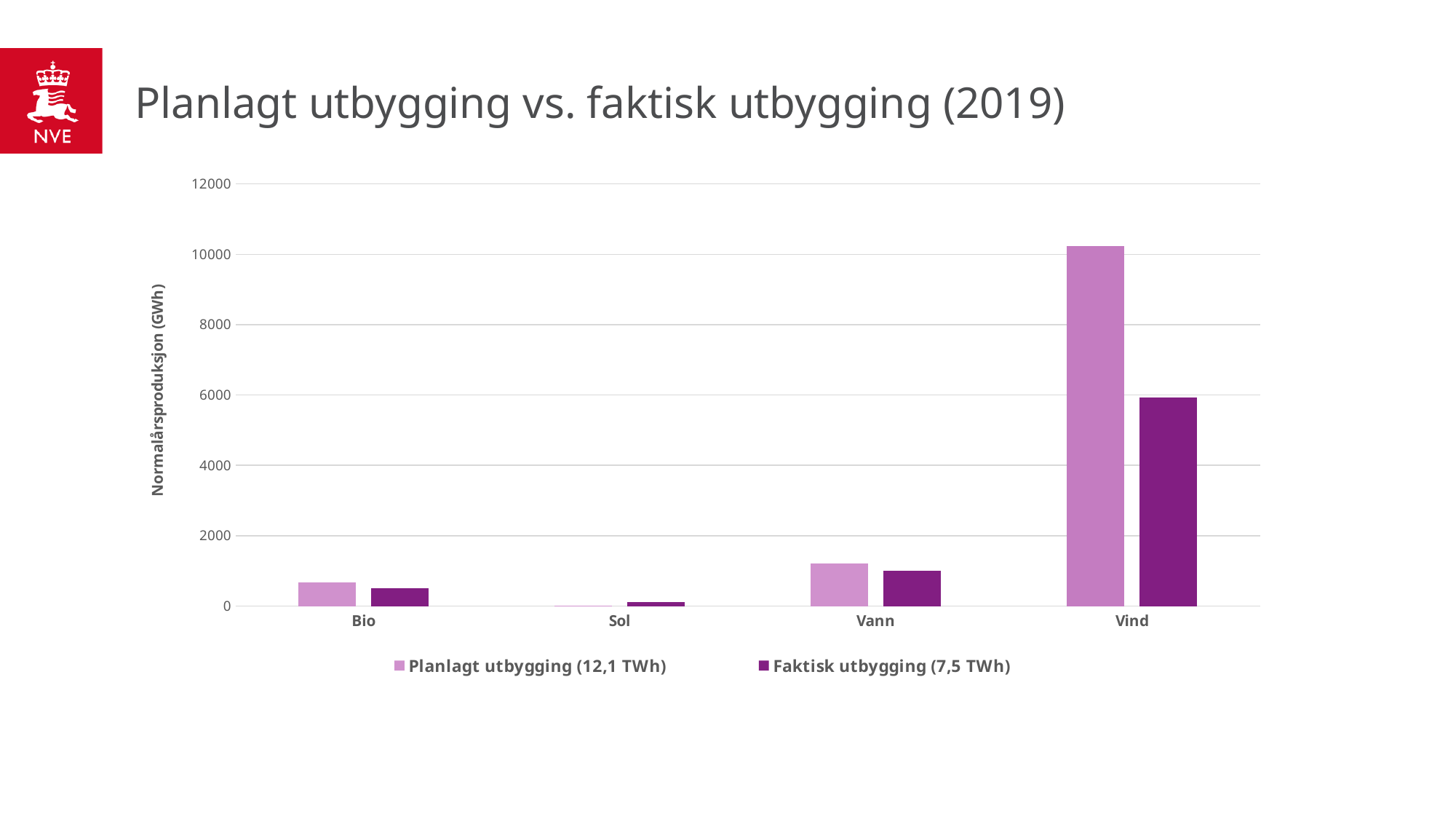
For Vind, which is larger: Planlagt utbygging or Faktisk utbygging? Planlagt utbygging Which category has the highest value for Faktisk utbygging? Vind What is the label of the y axis? Normalårsproduksjon (GWh) How many series does the legend list? 2 How many categories are shown on the x axis? 4 Which category has the highest value for Planlagt utbygging? Vind For Sol, which is larger: Planlagt utbygging or Faktisk utbygging? Faktisk utbygging Is the Planlagt utbygging value for Vann greater or less than 2000? less Which category has the lowest value for Planlagt utbygging? Sol Is the Planlagt utbygging value for Vind greater or less than 8000? greater Is the Faktisk utbygging value for Vind greater or less than 8000? less What kind of chart is shown on the slide? Bar chart